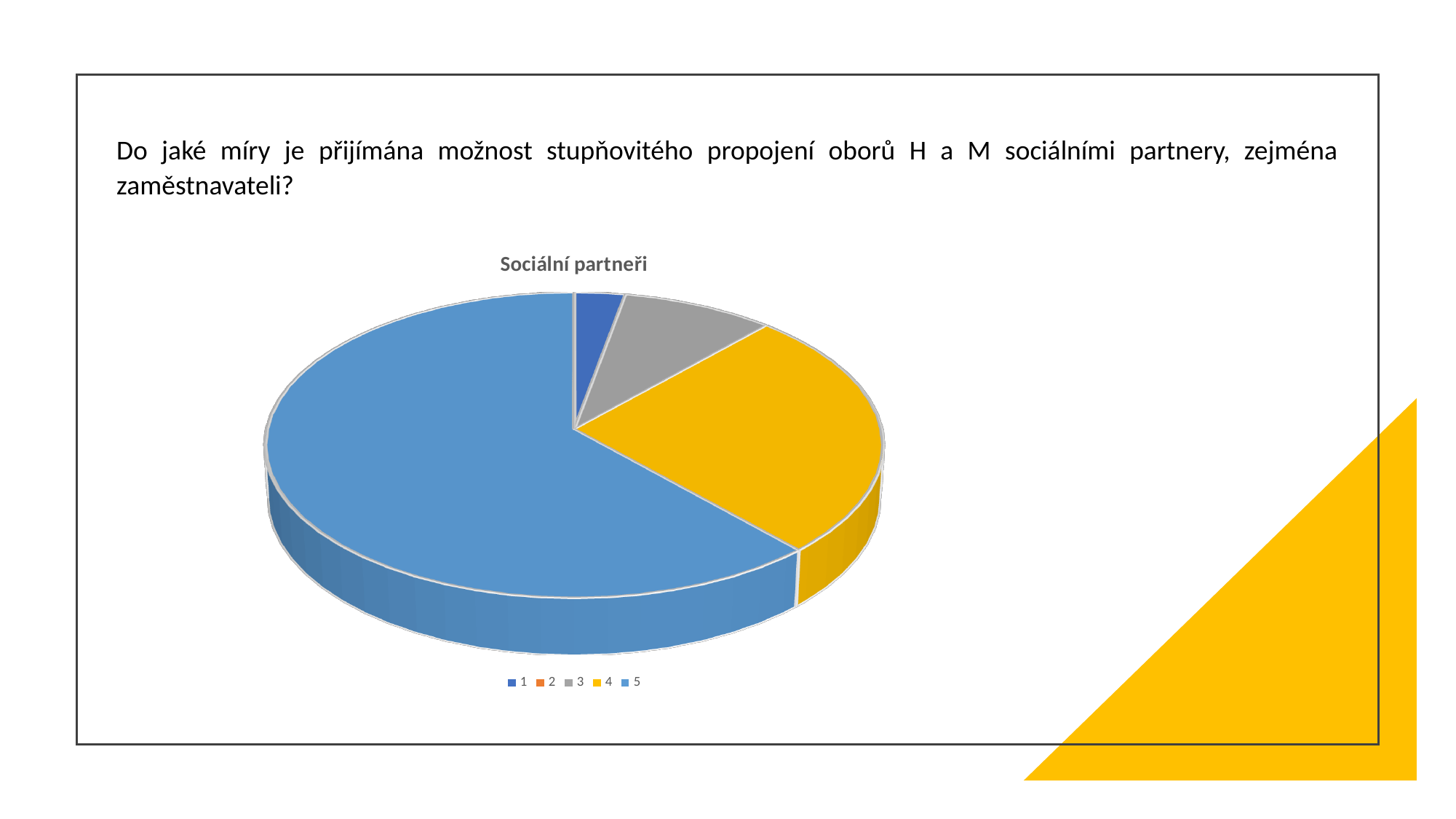
Which is larger, the slice for category 3 or the slice for category 1? 3 What is the title of the chart? Sociální partneři How many slices are visible in the pie? 4 Which is larger, the slice for category 1 or the slice for category 5? 5 Which category has the largest slice of the pie? 5 Which is larger, the slice for category 5 or the slice for category 4? 5 What kind of chart is shown on the slide? pie chart How many entries does the chart legend list? 5 What colour is the slice for category 4? yellow